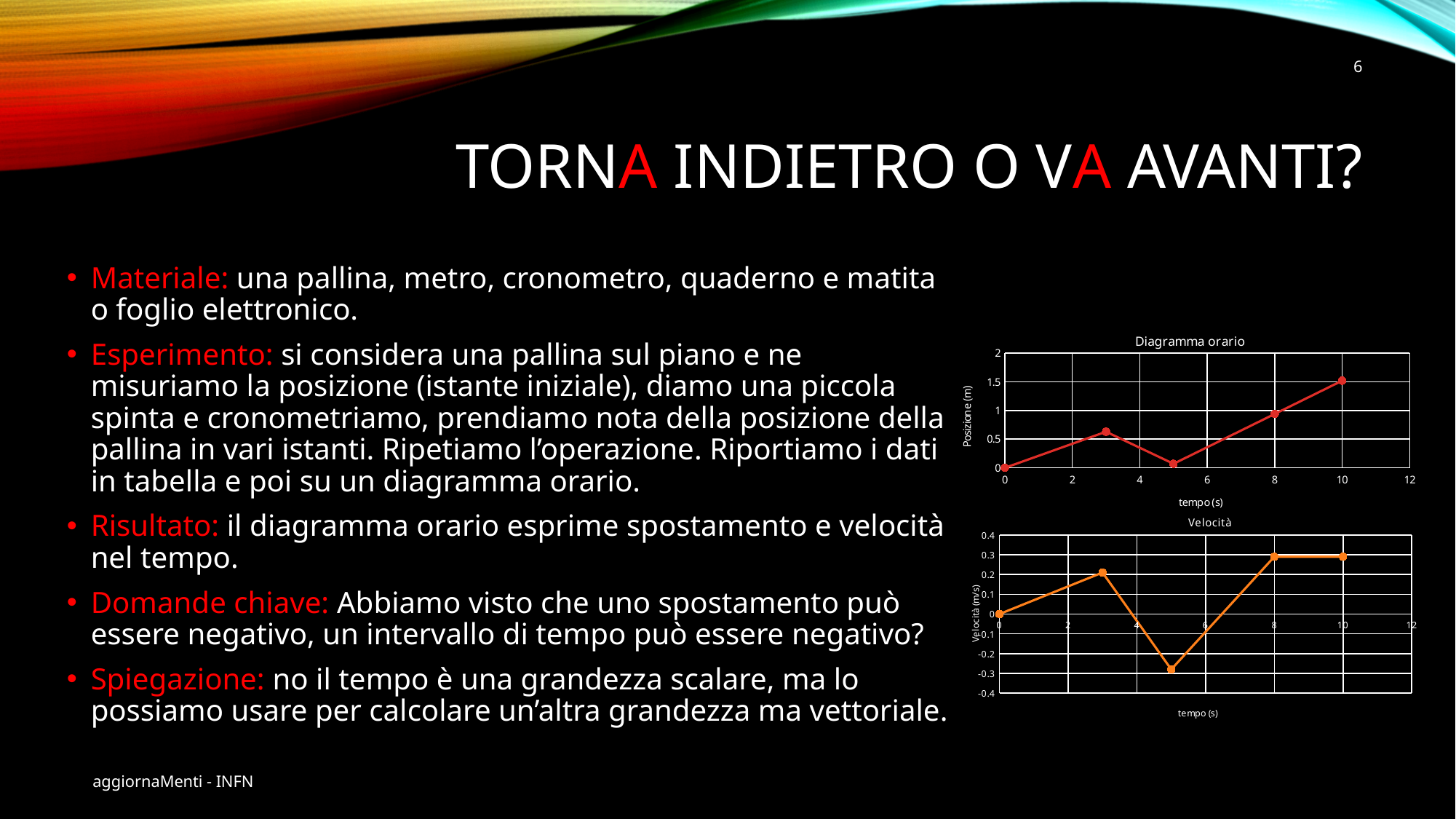
What is the y-axis label of the 'Diagramma orario' chart? Posizione (m) In the 'Diagramma orario' chart, at which time (s) is the position highest? 10 In the 'Velocità' chart, is the velocity at time 5 s greater or less than -0.2? less In the 'Diagramma orario' chart, how many data points are plotted? 5 In the 'Diagramma orario' chart, which is larger: the position at time 3 s or at time 8 s? time 8 s In the 'Diagramma orario' chart, does the position rise or fall between time 5 s and time 10 s? rise In the 'Diagramma orario' chart, is the position at time 10 s greater or less than 1? greater In the 'Velocità' chart, how many data points are plotted? 5 What kind of chart is the 'Velocità' chart? line chart In the 'Velocità' chart, at which time (s) is the velocity lowest? 5 What kind of chart is the 'Diagramma orario' chart? line chart In the 'Diagramma orario' chart, is the position at time 3 s greater or less than 1? less